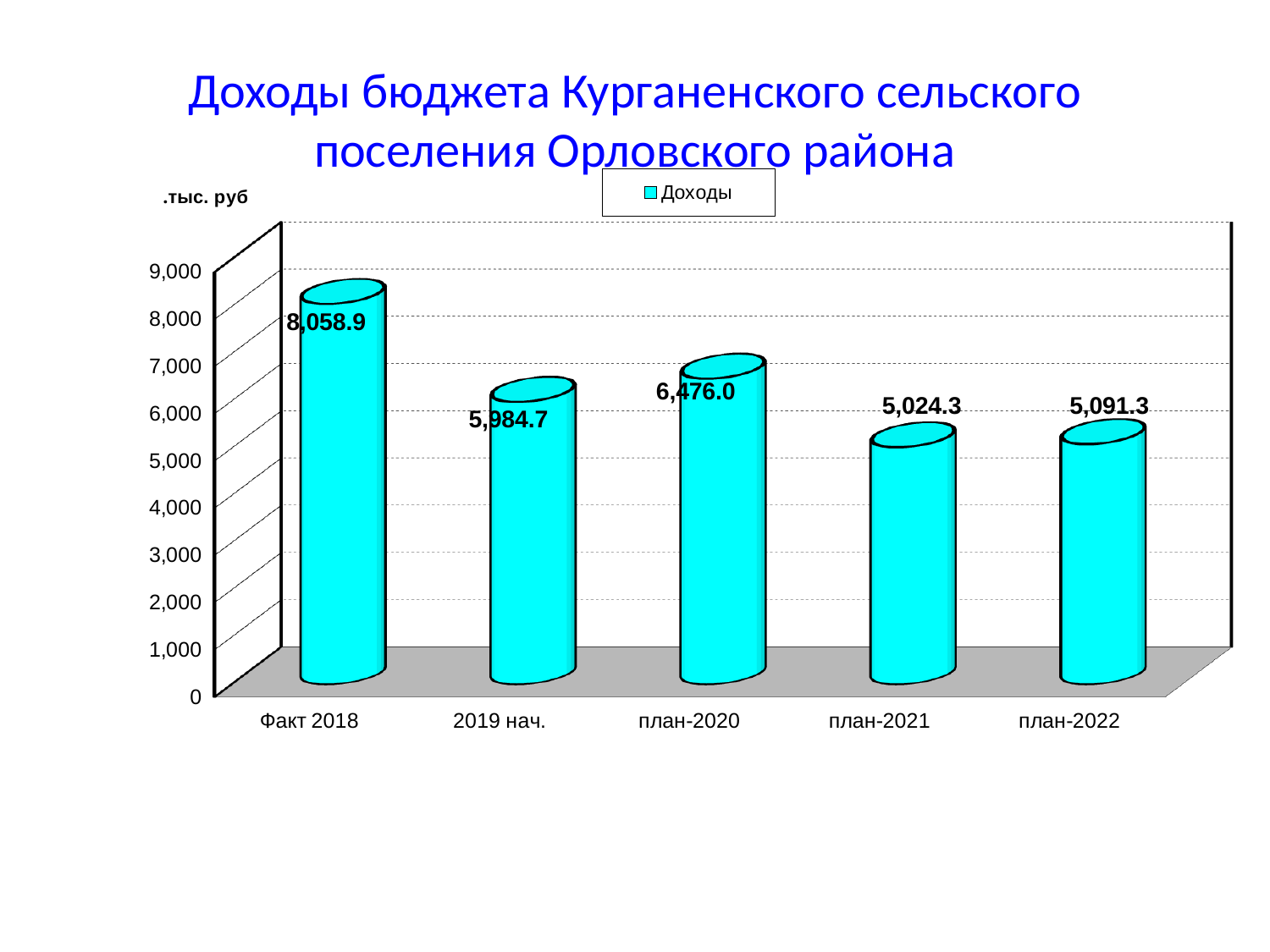
How many categories are shown on the x axis? 5 What is the value for Факт 2018? 8,058.9 What is the value for план-2020? 6,476.0 What is the difference between the values for Факт 2018 and 2019 нач.? 2,074.2 Is the value for план-2021 greater or less than 6,000? less What is the difference between the values for план-2022 and план-2021? 67.0 Which is larger, the value for 2019 нач. or the value for план-2020? план-2020 Which category has the highest value? Факт 2018 What kind of chart is shown on the slide? bar chart How many series does the legend list? 1 Which category has the lowest value? план-2021 What is the value for план-2022? 5,091.3